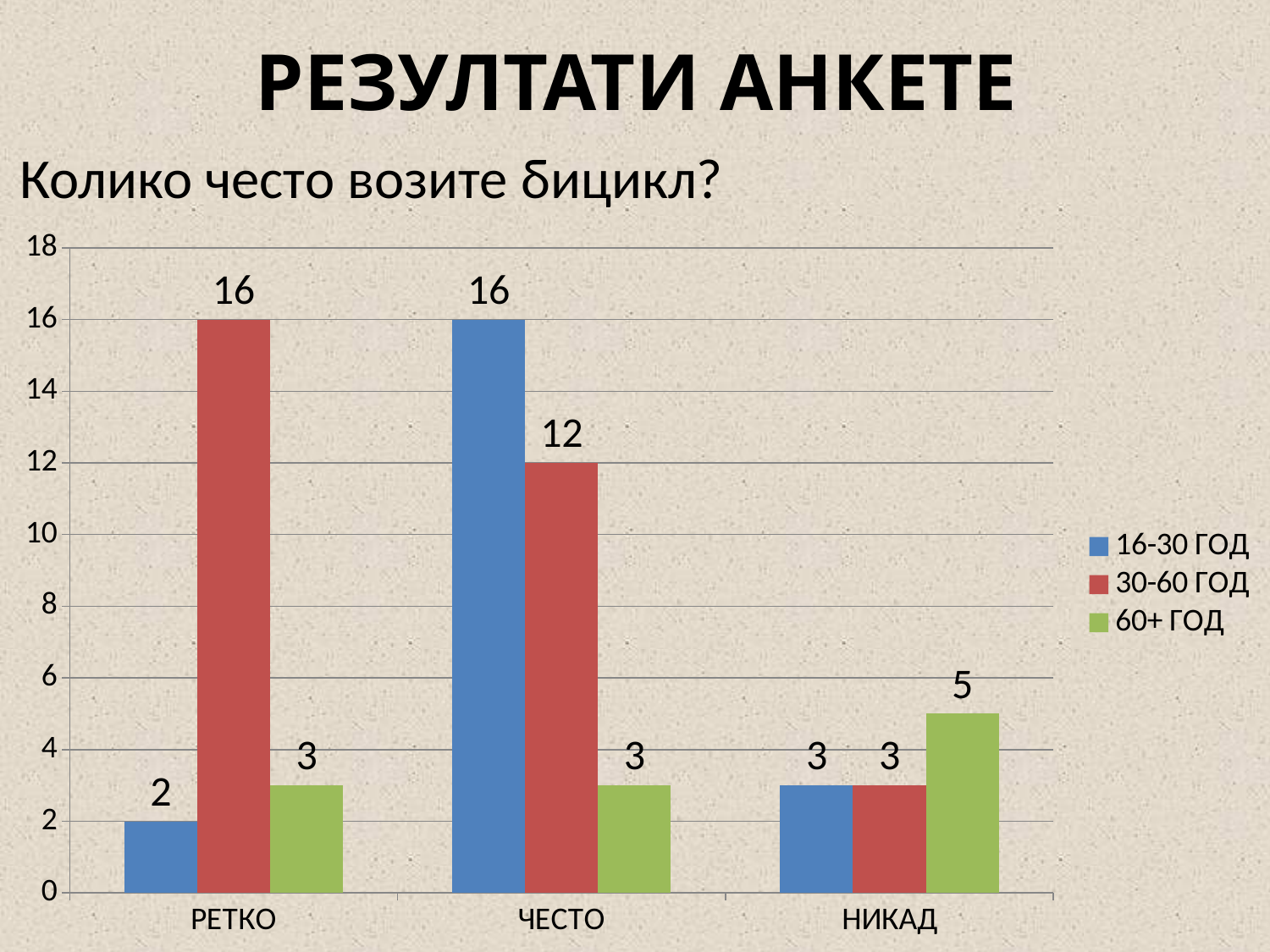
How many series does the legend list? 3 What kind of chart is shown on the slide? bar chart Which is larger: the 60+ ГОД value for НИКАД or the 60+ ГОД value for РЕТКО? НИКАД What is the value for 30-60 ГОД in the ЧЕСТО category? 12 Which age group has the lowest value in the ЧЕСТО category? 60+ ГОД How many categories are shown on the x axis? 3 What is the total of the three values in the НИКАД category? 11 What is the difference between the 16-30 ГОД and 30-60 ГОД values in the ЧЕСТО category? 4 What is the value for 16-30 ГОД in the РЕТКО category? 2 Which age group has the highest value in the РЕТКО category? 30-60 ГОД What is the value for 60+ ГОД in the НИКАД category? 5 Which colour represents the 60+ ГОД series? green